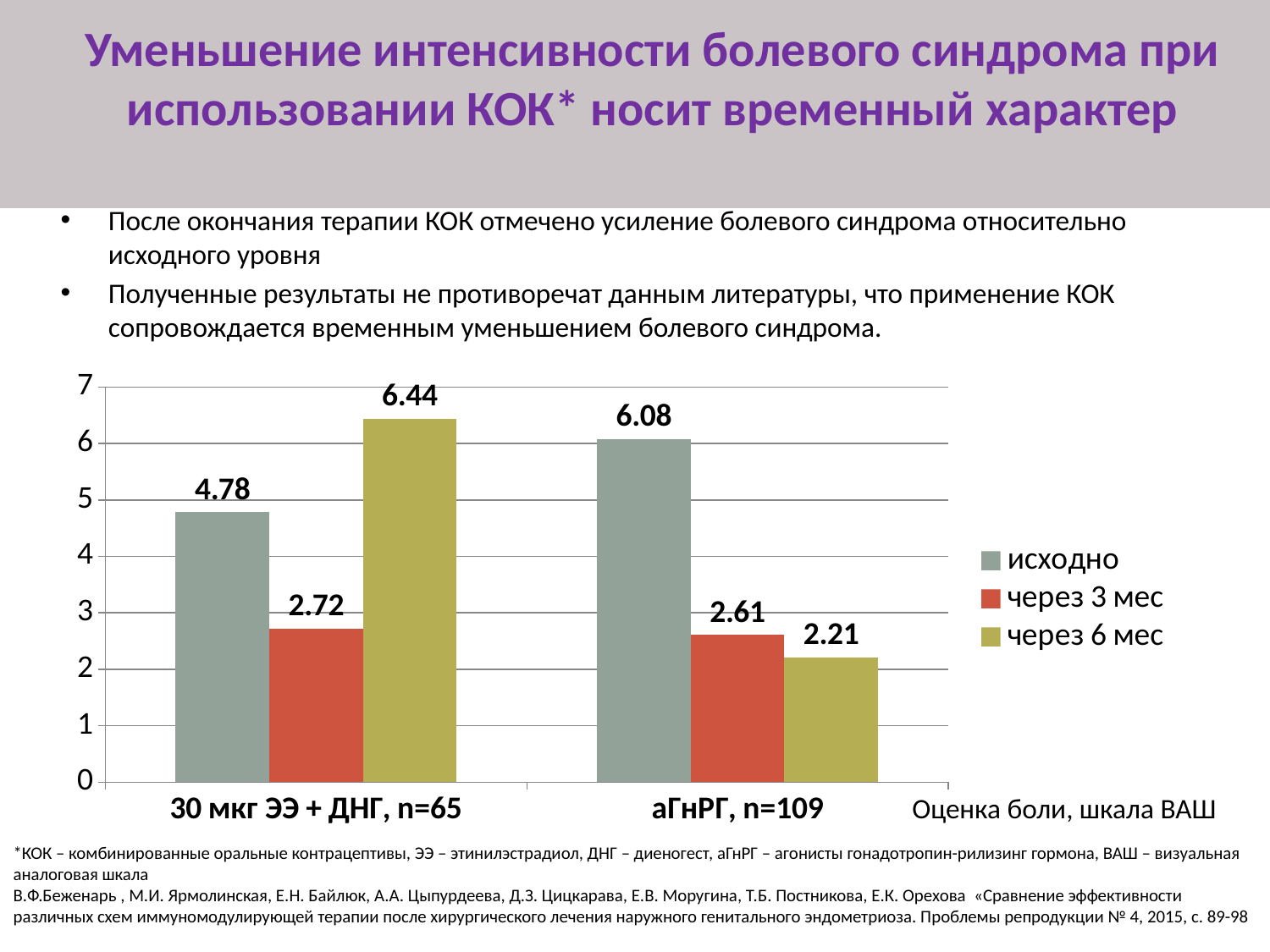
What is the value for "исходно" in the "30 мкг ЭЭ + ДНГ, n=65" group? 4.78 Which bar has the highest value on the chart? через 6 мес, 30 мкг ЭЭ + ДНГ, n=65 Which bar has the lowest value on the chart? через 6 мес, аГнРГ, n=109 What is the difference between the "через 6 мес" and "исходно" values in the "30 мкг ЭЭ + ДНГ, n=65" group? 1.66 How many groups are shown on the x axis? 2 What kind of chart is shown on the slide? bar chart Is the "через 6 мес" value for "аГнРГ, n=109" greater or less than 3? less What is the value for "через 6 мес" in the "аГнРГ, n=109" group? 2.21 Which is larger: the "исходно" value for "30 мкг ЭЭ + ДНГ, n=65" or for "аГнРГ, n=109"? аГнРГ, n=109 What is the value for "через 3 мес" in the "30 мкг ЭЭ + ДНГ, n=65" group? 2.72 What is the difference between the "исходно" and "через 3 мес" values in the "аГнРГ, n=109" group? 3.47 How many series does the legend list? 3